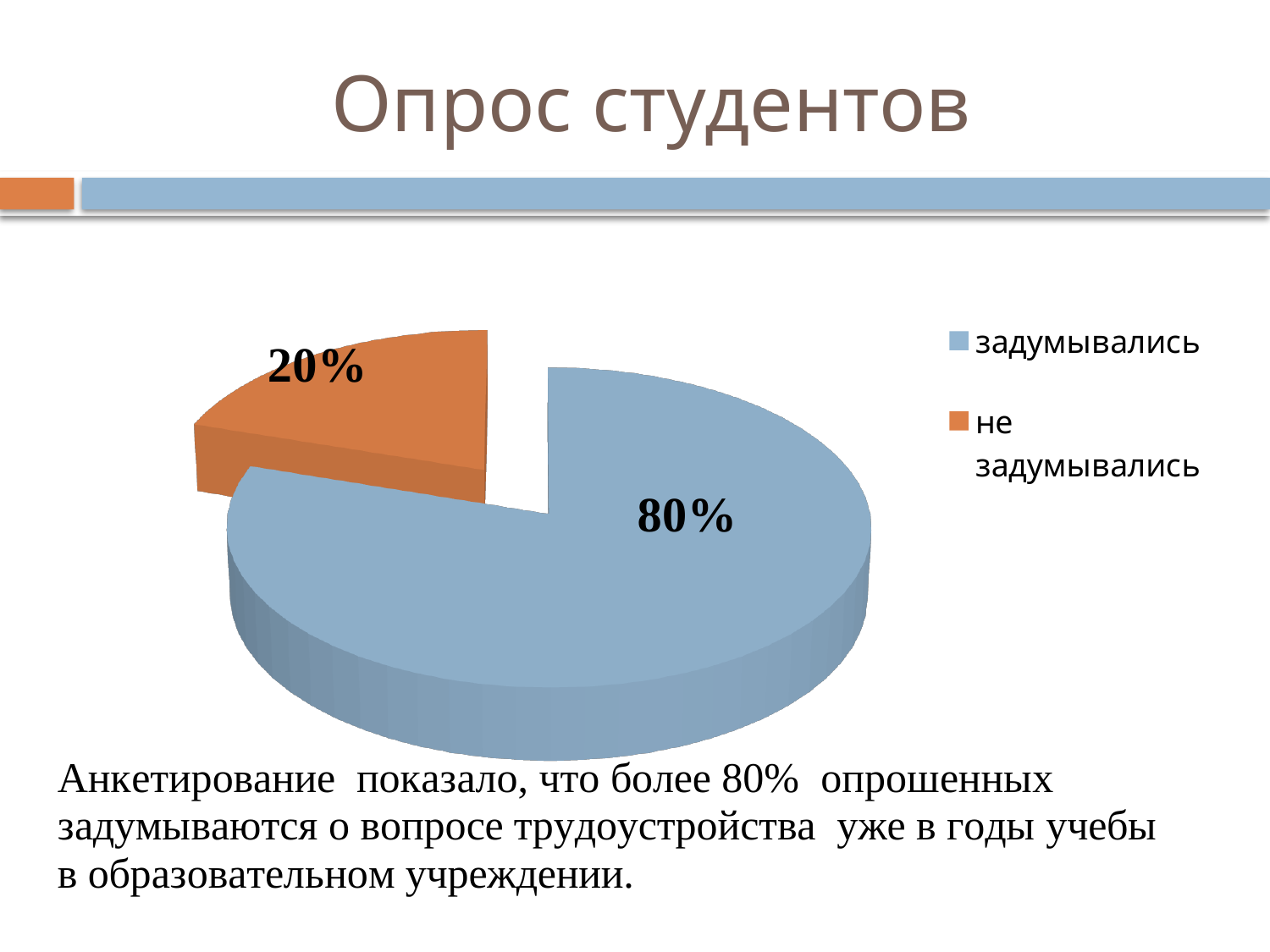
Which category has the largest slice of the pie? задумывались What kind of chart is shown on the slide? pie chart Which is larger: the "задумывались" slice or the "не задумывались" slice? задумывались What is the difference in percentage points between the "задумывались" and "не задумывались" slices? 60% Which category has the smallest slice of the pie? не задумывались How many slices does the pie chart have? 2 What colour is the "не задумывались" slice? orange What share of the pie is labelled "не задумывались"? 20% How many entries does the legend list? 2 What is the title of the slide containing the chart? Опрос студентов What share of the pie is labelled "задумывались"? 80%